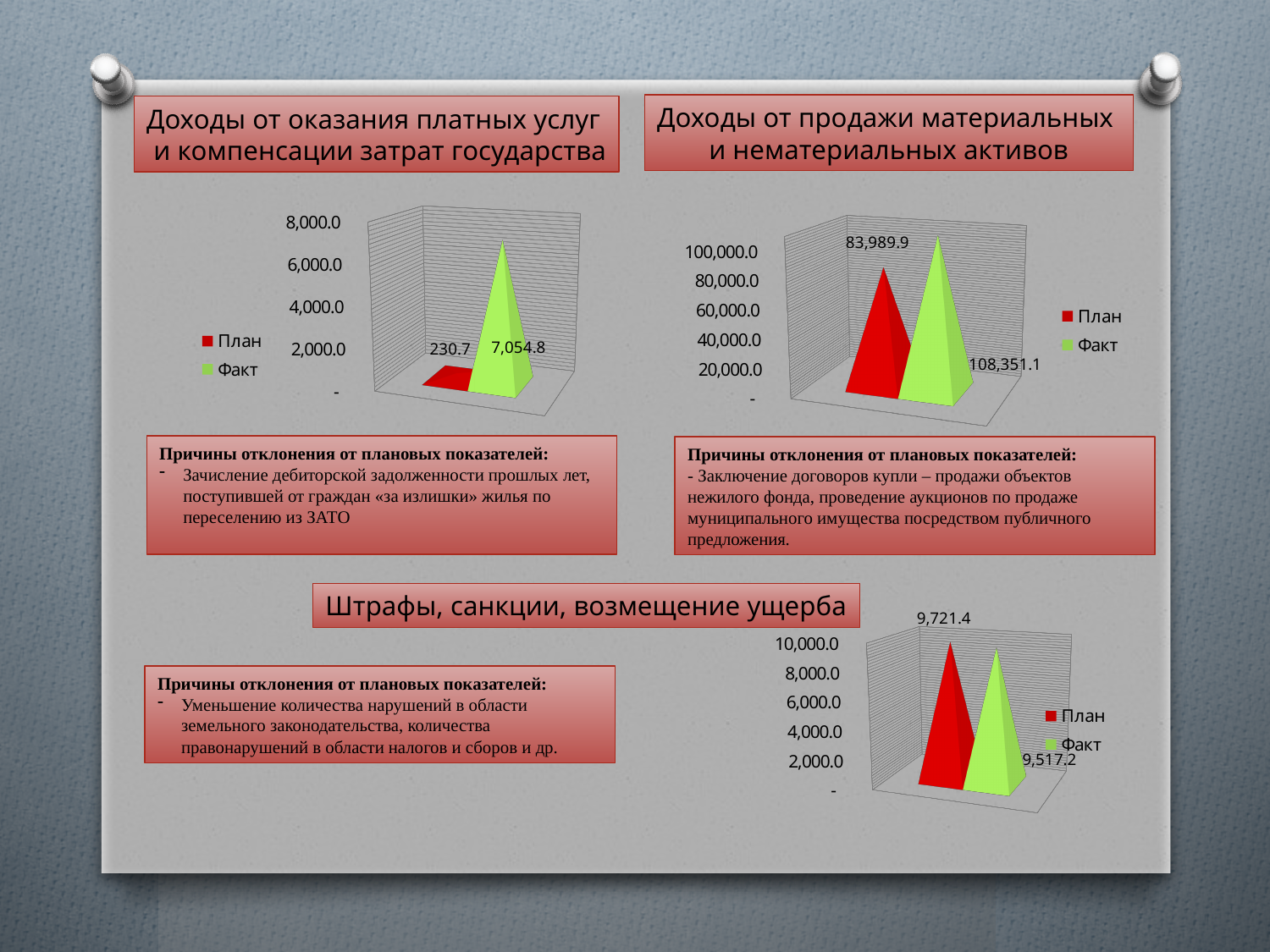
In the chart titled «Доходы от продажи материальных и нематериальных активов», by how much does Факт exceed План? 24,361.2 In the chart titled «Доходы от оказания платных услуг и компенсации затрат государства», what is the difference between Факт and План? 6,824.1 How many series does the legend list in the chart titled «Штрафы, санкции, возмещение ущерба»? 2 In the chart titled «Доходы от продажи материальных и нематериальных активов», which series is larger, План or Факт? Факт In the chart titled «Доходы от продажи материальных и нематериальных активов», what is the value for План? 83,989.9 In the chart titled «Доходы от оказания платных услуг и компенсации затрат государства», what is the value for Факт? 7,054.8 In the chart titled «Штрафы, санкции, возмещение ущерба», what is the value for План? 9,721.4 What kind of chart is the one titled «Доходы от оказания платных услуг и компенсации затрат государства»? Bar chart In the chart titled «Штрафы, санкции, возмещение ущерба», what is the value for Факт? 9,517.2 In the chart titled «Доходы от продажи материальных и нематериальных активов», what is the value for Факт? 108,351.1 In the chart titled «Штрафы, санкции, возмещение ущерба», what is the difference between План and Факт? 204.2 In the chart titled «Доходы от оказания платных услуг и компенсации затрат государства», what is the value for План? 230.7